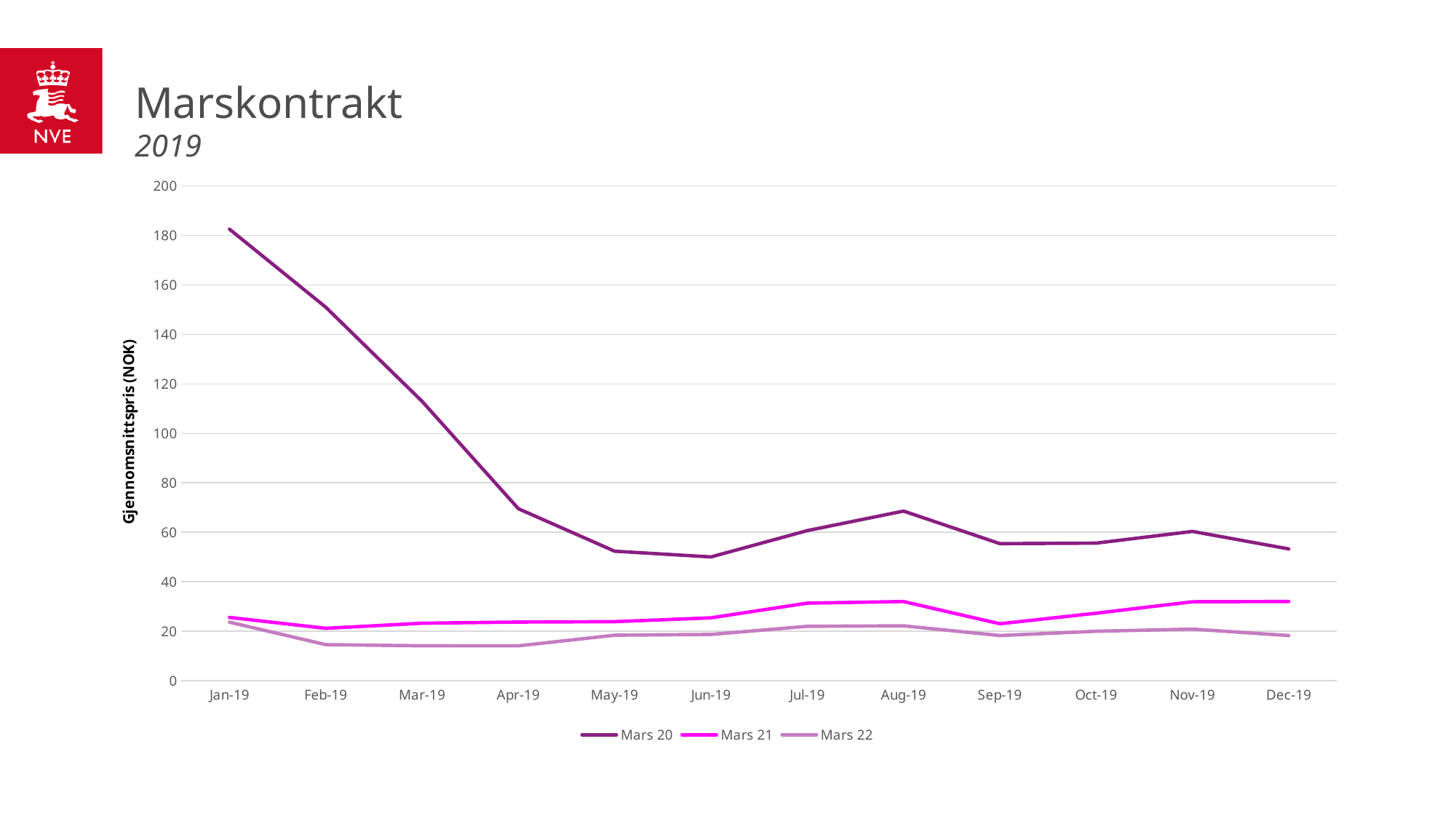
Is the value for Mars 21 in Dec-19 greater or less than 20? greater Does the Mars 20 series rise or fall from Jan-19 to Apr-19? fall Is the value for Mars 20 in Jan-19 greater or less than 160? greater What kind of chart is shown on the slide? line chart How many series does the legend list? 3 How many months are plotted along the x axis? 12 What is the label on the y axis? Gjennomsnittspris (NOK) Which series has the larger value in Jan-19, Mars 20 or Mars 21? Mars 20 Which series has the larger value in Dec-19, Mars 21 or Mars 22? Mars 21 Is the value for Mars 20 in Apr-19 greater or less than 80? less In which month does the Mars 20 series reach its highest value? Jan-19